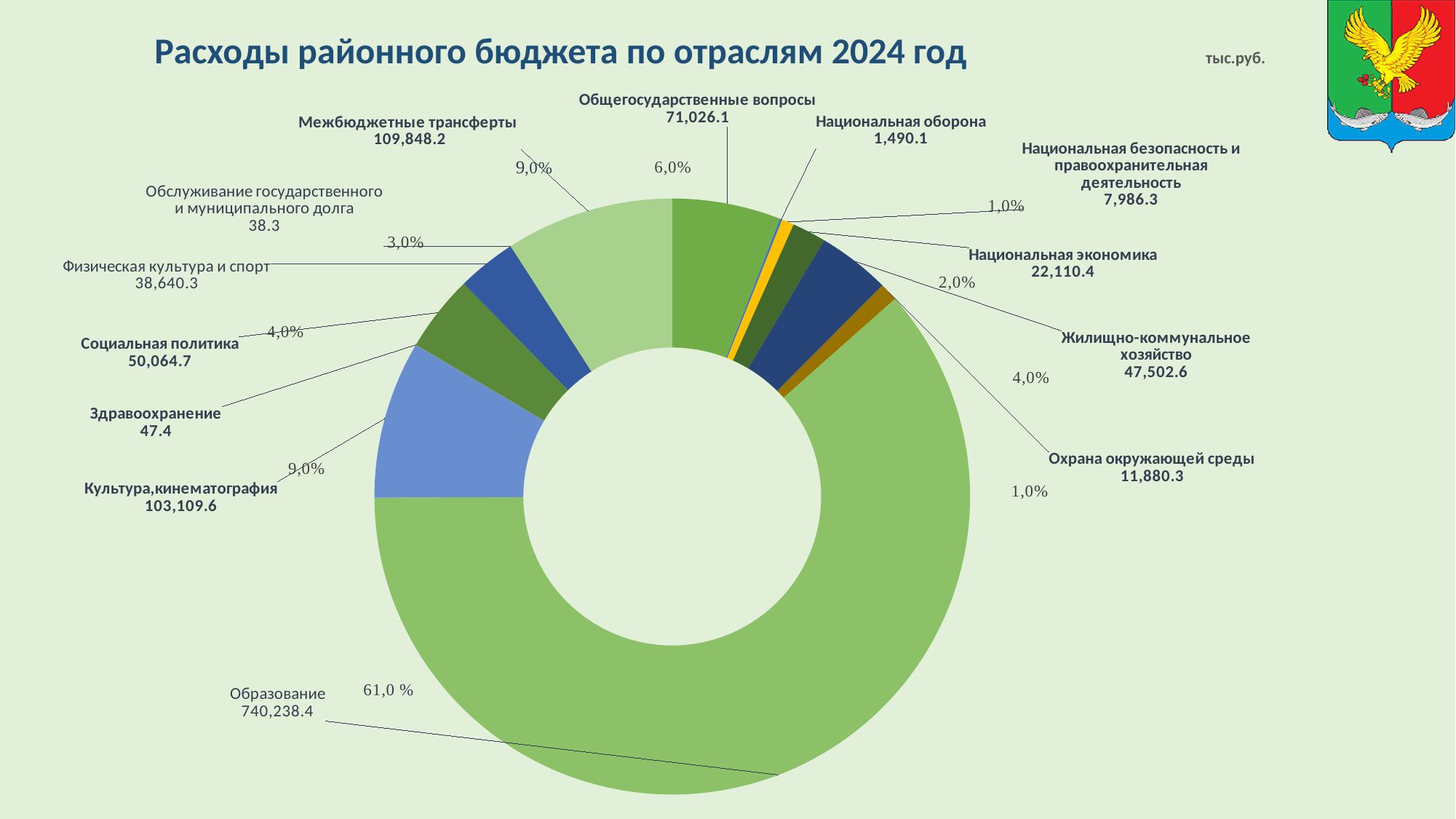
What type of chart is shown on the slide? Doughnut (pie) chart Which category has the largest expenditure? Образование How many categories are shown in the chart? 13 What is the value for Здравоохранение? 47.4 What is the value for Межбюджетные трансферты? 109,848.2 What is the value for Образование? 740,238.4 What is the difference between Межбюджетные трансферты and Культура,кинематография? 6,738.6 What is the value for Национальная экономика? 22,110.4 Which is larger: Социальная политика or Жилищно-коммунальное хозяйство? Социальная политика Which category has the smallest expenditure? Обслуживание государственного и муниципального долга What share of the total does Образование account for? 61,0 % In what units are the values on the chart given? тыс.руб.